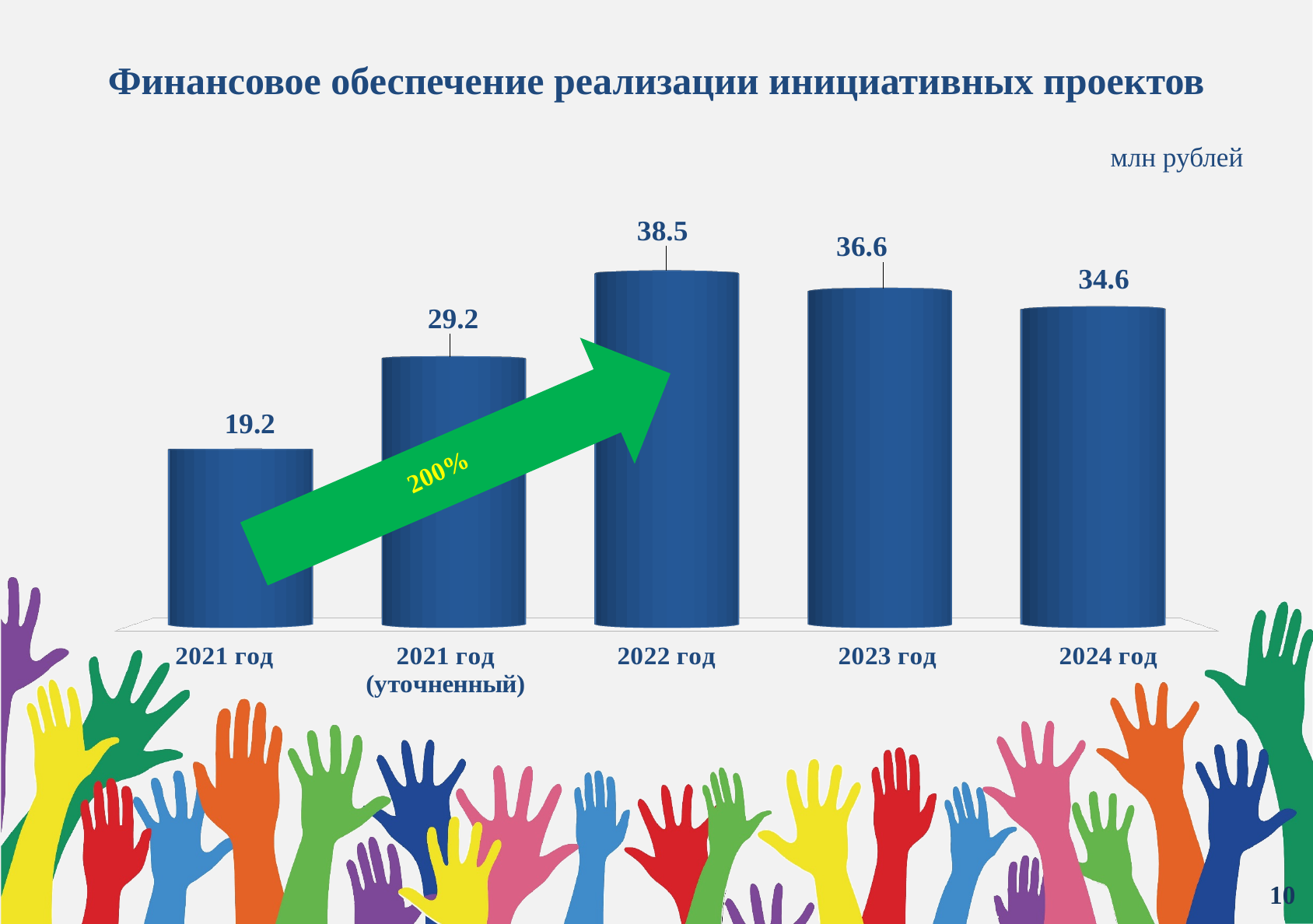
How many bars are shown in the chart? 5 What is the difference between the values for 2023 год and 2024 год? 2.0 What is the value for 2024 год? 34.6 What unit of measurement is indicated for the chart values? млн рублей Which category has the highest value? 2022 год Which category has the lowest value? 2021 год Which is larger, the value for 2023 год or the value for 2024 год? 2023 год What is the value for 2021 год (уточненный)? 29.2 What is the difference between the values for 2022 год and 2021 год? 19.3 What is the value for 2022 год? 38.5 What kind of chart is shown on the slide? bar chart Do the values rise or fall from 2022 год to 2024 год? fall